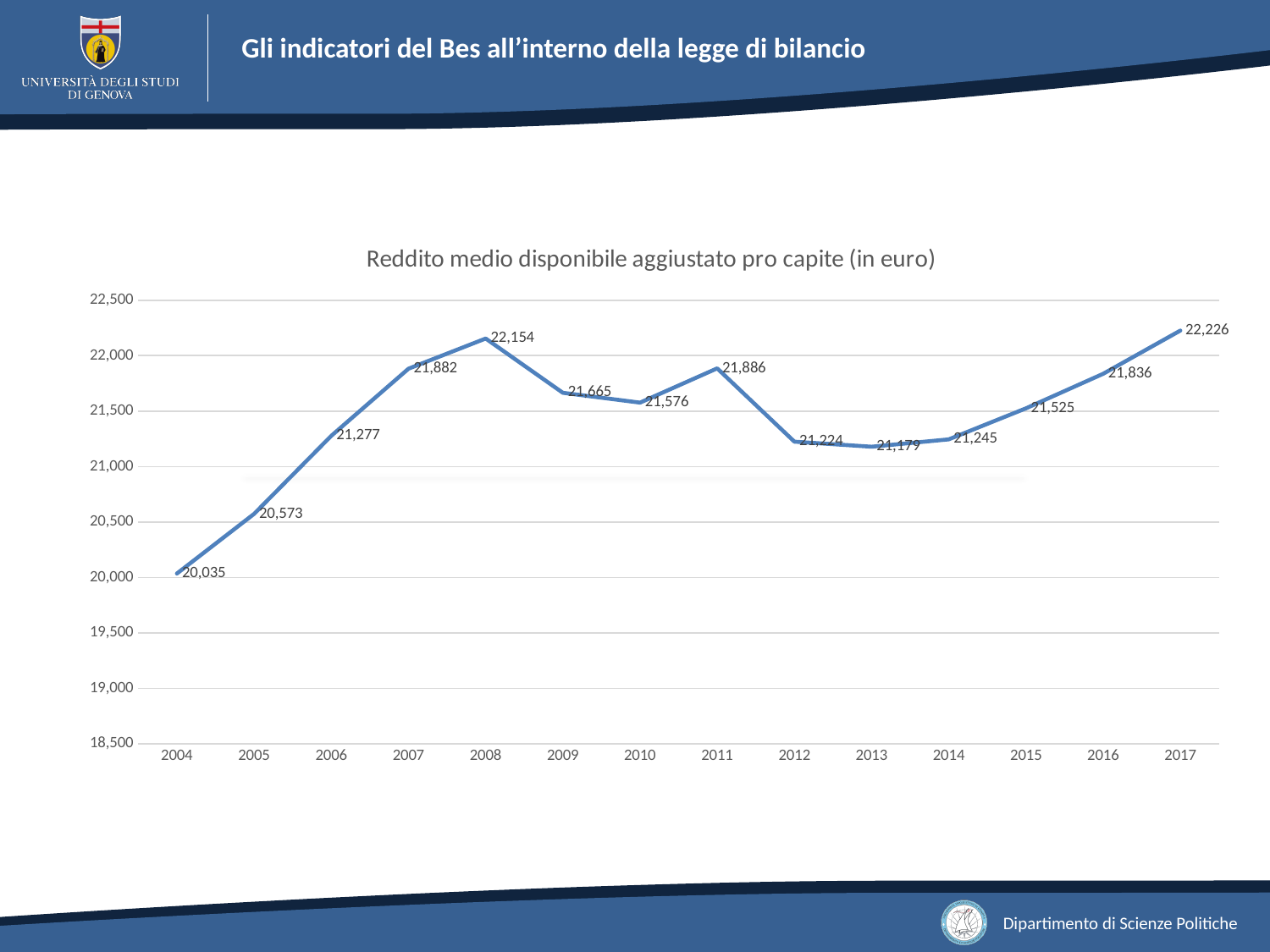
What is the difference between the values for 2008 and 2009? 489 What is the difference between the values for 2017 and 2004? 2,191 What is the title of the chart? Reddito medio disponibile aggiustato pro capite (in euro) Which is larger, the value for 2008 or the value for 2011? 2008 Which year has the highest value? 2017 Which year has the lowest value? 2004 Is the value for 2006 greater or less than 21,000? greater What is the value for 2004? 20,035 How many years are plotted on the x axis? 14 What is the value for 2011? 21,886 What is the value for 2013? 21,179 What kind of chart is shown? line chart